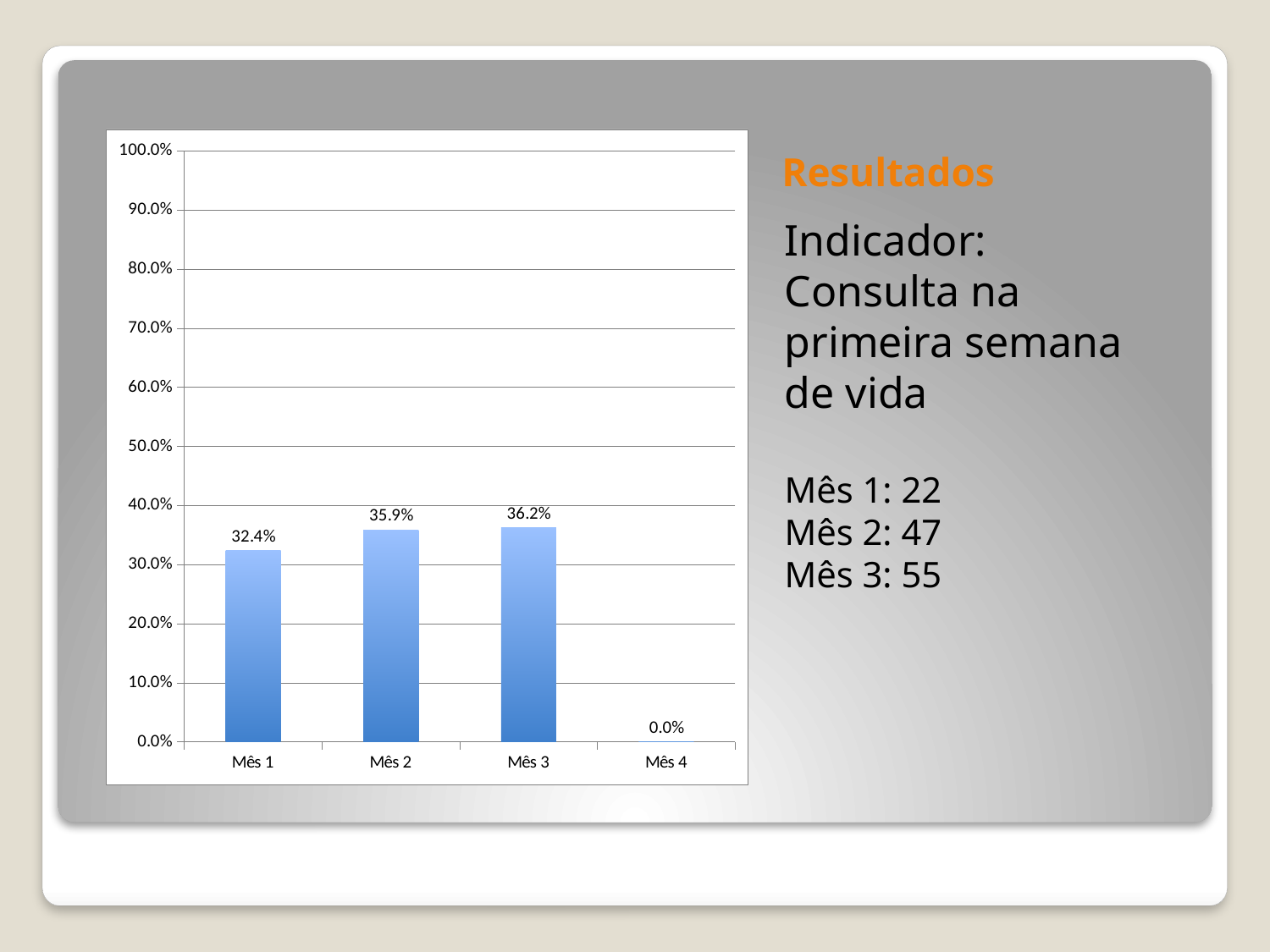
What is the value for Mês 3? 36.2% What is the difference between the values for Mês 2 and Mês 1? 3.5% What is the highest value shown on the y axis? 100.0% What is the value for Mês 2? 35.9% What is the value for Mês 4? 0.0% What is the value for Mês 1? 32.4% Which month has the highest value? Mês 3 How many categories are shown on the x axis? 4 What is the difference between the values for Mês 3 and Mês 1? 3.8% What kind of chart is shown on the slide? Bar chart Which month has the lowest value? Mês 4 Which is larger, the value for Mês 1 or the value for Mês 2? Mês 2